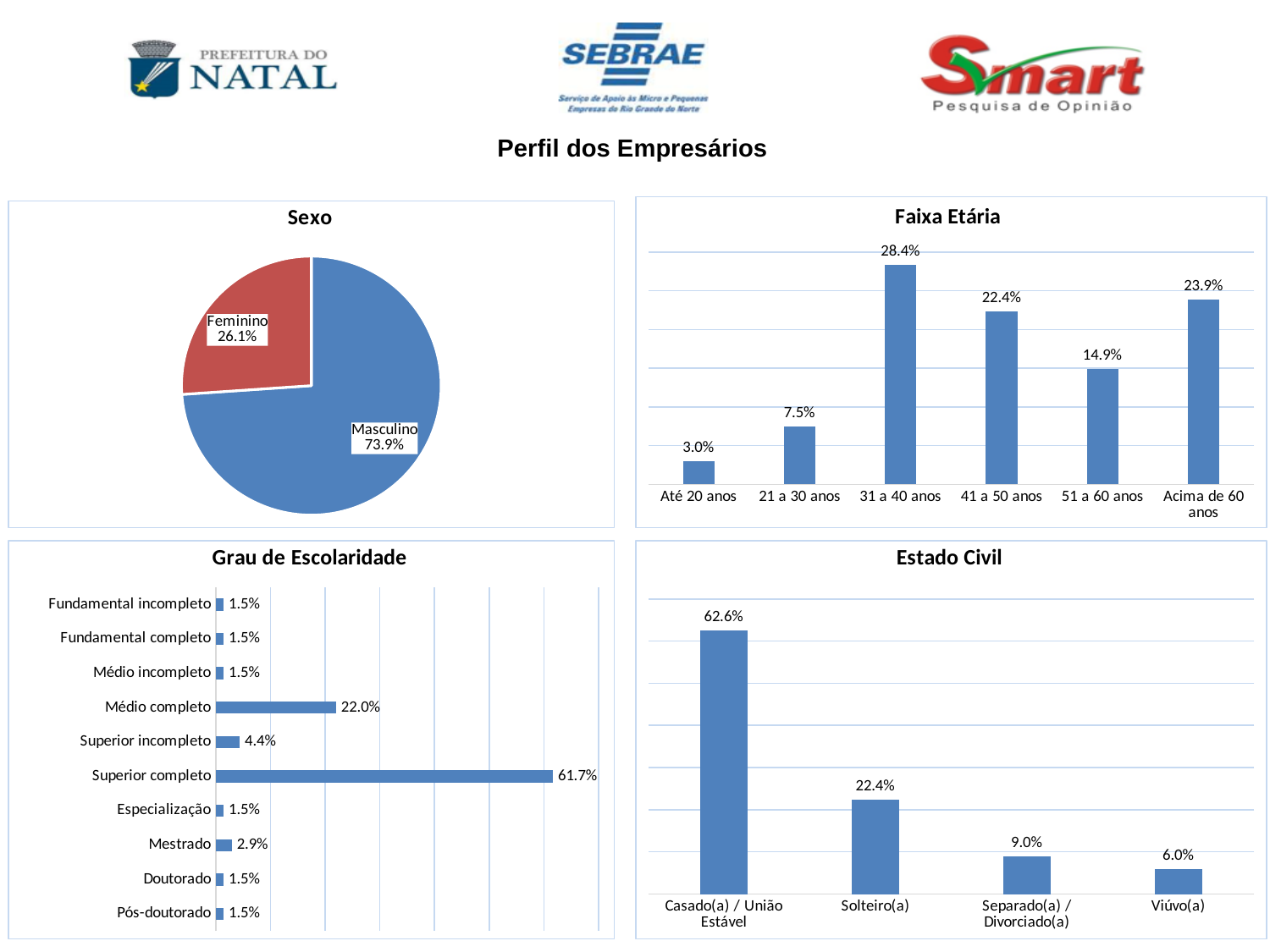
What kind of chart is the 'Grau de Escolaridade' chart? bar chart In the 'Estado Civil' chart, which is larger: Solteiro(a) or Separado(a) / Divorciado(a)? Solteiro(a) How many age groups are shown in the 'Faixa Etária' chart? 6 What kind of chart is the 'Sexo' chart? pie chart In the 'Faixa Etária' chart, which age group has the highest value? 31 a 40 anos In the 'Grau de Escolaridade' chart, which category has the highest value? Superior completo In the 'Grau de Escolaridade' chart, what is the value for Médio completo? 22.0% In the 'Faixa Etária' chart, what is the difference between 31 a 40 anos and 21 a 30 anos? 20.9% In the 'Sexo' chart, what share is Feminino? 26.1% In the 'Estado Civil' chart, which category has the lowest value? Viúvo(a) In the 'Faixa Etária' chart, what is the value for 51 a 60 anos? 14.9% In the 'Sexo' chart, what share is Masculino? 73.9%